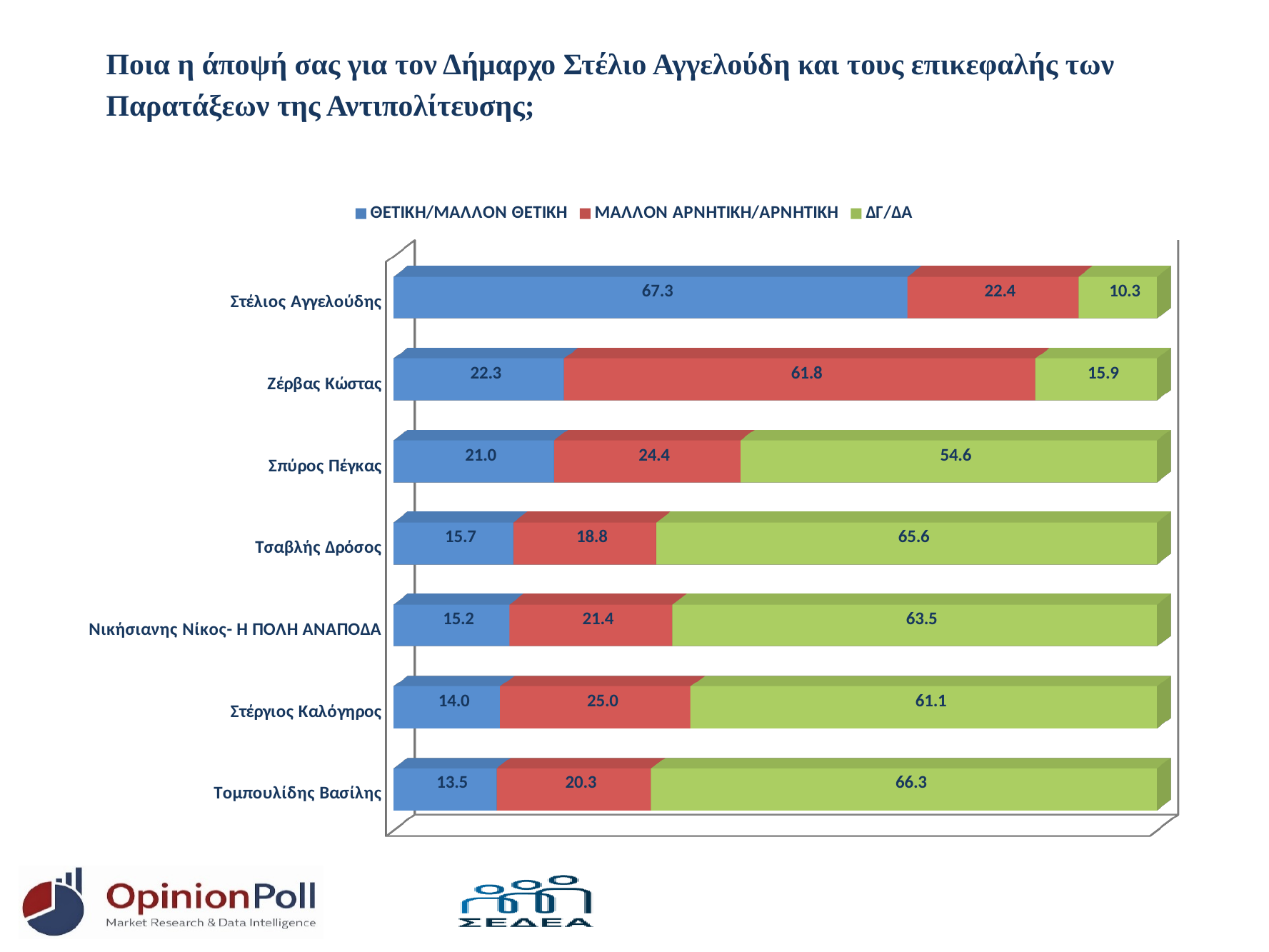
Which person has the highest ΔΓ/ΔΑ value? Τομπουλίδης Βασίλης Which person has the highest ΘΕΤΙΚΗ/ΜΑΛΛΟΝ ΘΕΤΙΚΗ value? Στέλιος Αγγελούδης What is the ΜΑΛΛΟΝ ΑΡΝΗΤΙΚΗ/ΑΡΝΗΤΙΚΗ value for Ζέρβας Κώστας? 61.8 What is the difference between the ΘΕΤΙΚΗ/ΜΑΛΛΟΝ ΘΕΤΙΚΗ values of Στέλιος Αγγελούδης and Ζέρβας Κώστας? 45.0 How many series does the legend list? 3 What is the ΔΓ/ΔΑ value for Τσαβλής Δρόσος? 65.6 What is the ΘΕΤΙΚΗ/ΜΑΛΛΟΝ ΘΕΤΙΚΗ value for Στέλιος Αγγελούδης? 67.3 Which is larger: the ΜΑΛΛΟΝ ΑΡΝΗΤΙΚΗ/ΑΡΝΗΤΙΚΗ value for Στέργιος Καλόγηρος or for Νικήσιανης Νίκος- Η ΠΟΛΗ ΑΝΑΠΟΔΑ? Στέργιος Καλόγηρος What kind of chart is shown on the slide? Stacked bar chart What is the total of the stacked bar for Σπύρος Πέγκας? 100.0 How many people (categories) are shown in the chart? 7 Which person has the lowest ΘΕΤΙΚΗ/ΜΑΛΛΟΝ ΘΕΤΙΚΗ value? Τομπουλίδης Βασίλης